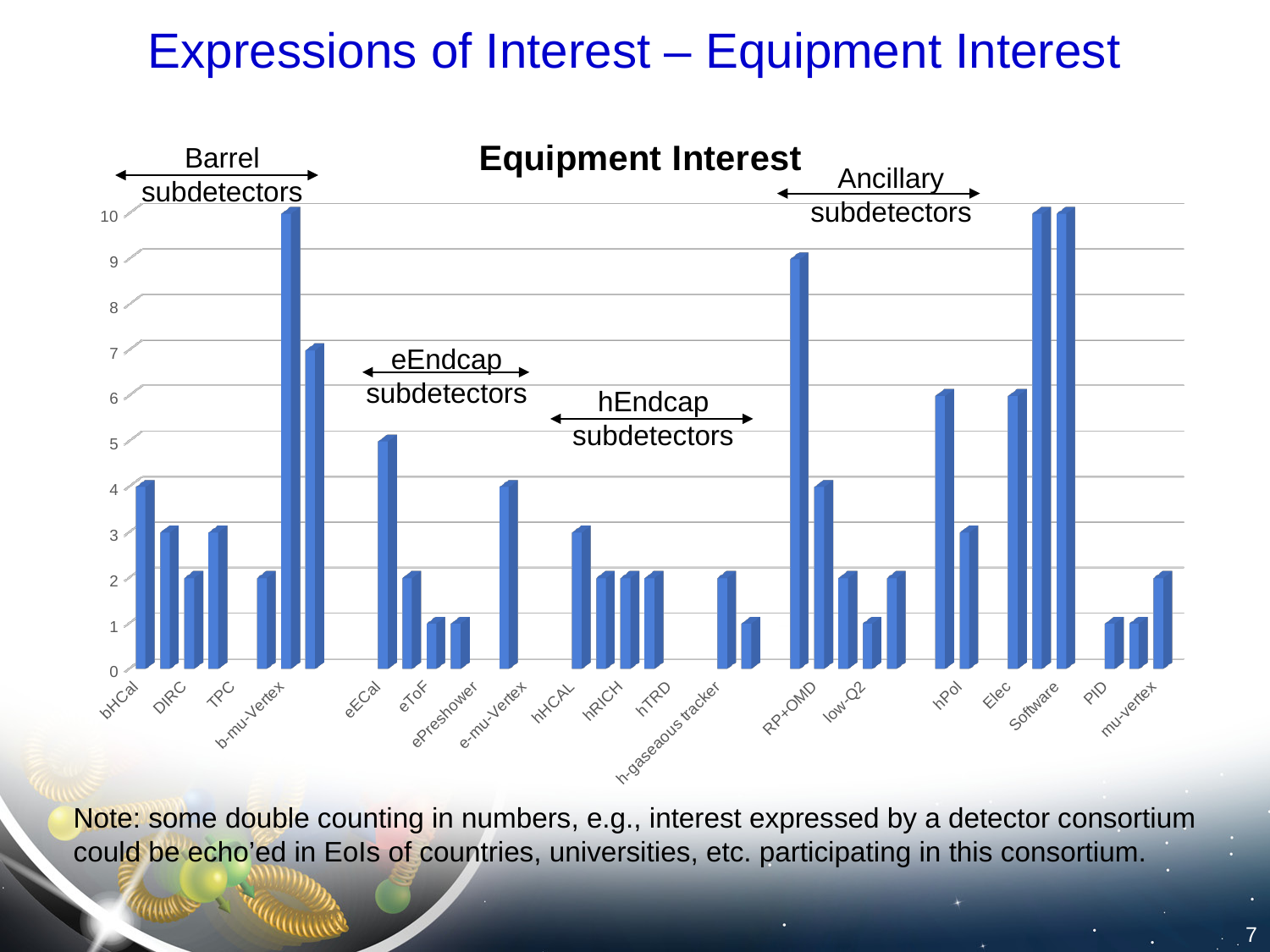
What is the maximum value shown on the vertical axis of the chart? 10 How many bars in the chart reach the value 10? 3 What kind of chart is shown on the slide? bar chart What is the title of the chart? Equipment Interest What is the value for bHCal, the first bar in the chart? 4 How many subdetector groups are labelled with arrows above the chart (Barrel, eEndcap, hEndcap, Ancillary)? 4 What is the lowest value reached by any bar in the Equipment Interest chart? 1 Is the value for bHCal greater or less than 3? greater Is the value for bHCal greater or less than 5? less What is the highest value reached by any bar in the Equipment Interest chart? 10